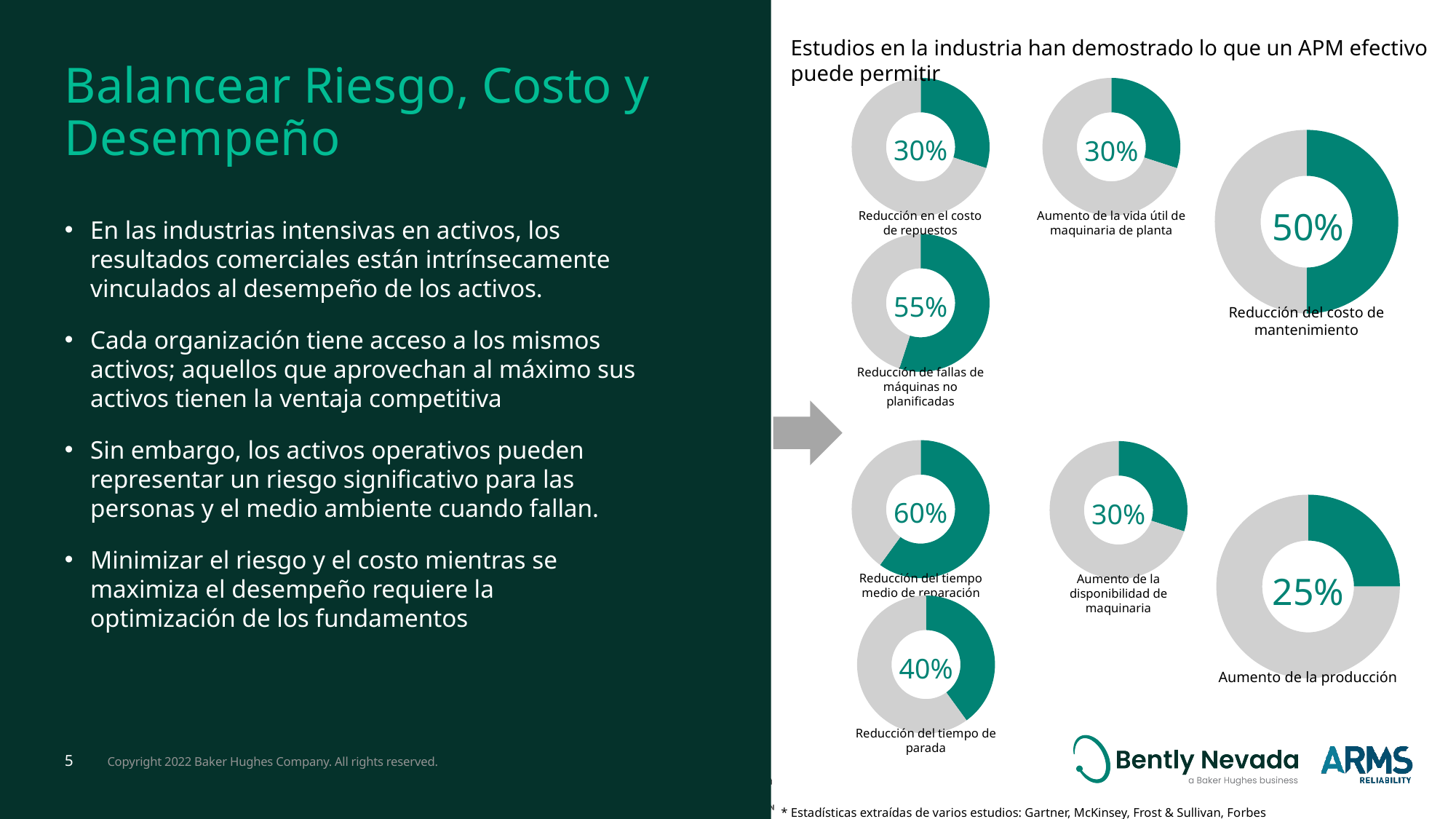
Which of the donut charts on the slide shows the highest percentage? Reducción del tiempo medio de reparación (60%) What value is shown in the donut chart labelled "Reducción de fallas de máquinas no planificadas"? 55% What is the difference between the percentage for "Reducción del tiempo medio de reparación" and the percentage for "Reducción del tiempo de parada"? 20% What value is shown in the donut chart labelled "Reducción del tiempo medio de reparación"? 60% Which is larger: the percentage for "Reducción del costo de mantenimiento" or the percentage for "Aumento de la producción"? Reducción del costo de mantenimiento How many donut charts are shown on the slide? 8 What value is shown in the donut chart labelled "Aumento de la producción"? 25% What value is shown in the donut chart labelled "Reducción del tiempo de parada"? 40% What kind of charts are used to display the percentages on the slide? Donut (pie) charts What value is shown in the donut chart labelled "Reducción del costo de mantenimiento"? 50% Which of the donut charts on the slide shows the lowest percentage? Aumento de la producción (25%) What value is shown in the donut chart labelled "Reducción en el costo de repuestos"? 30%